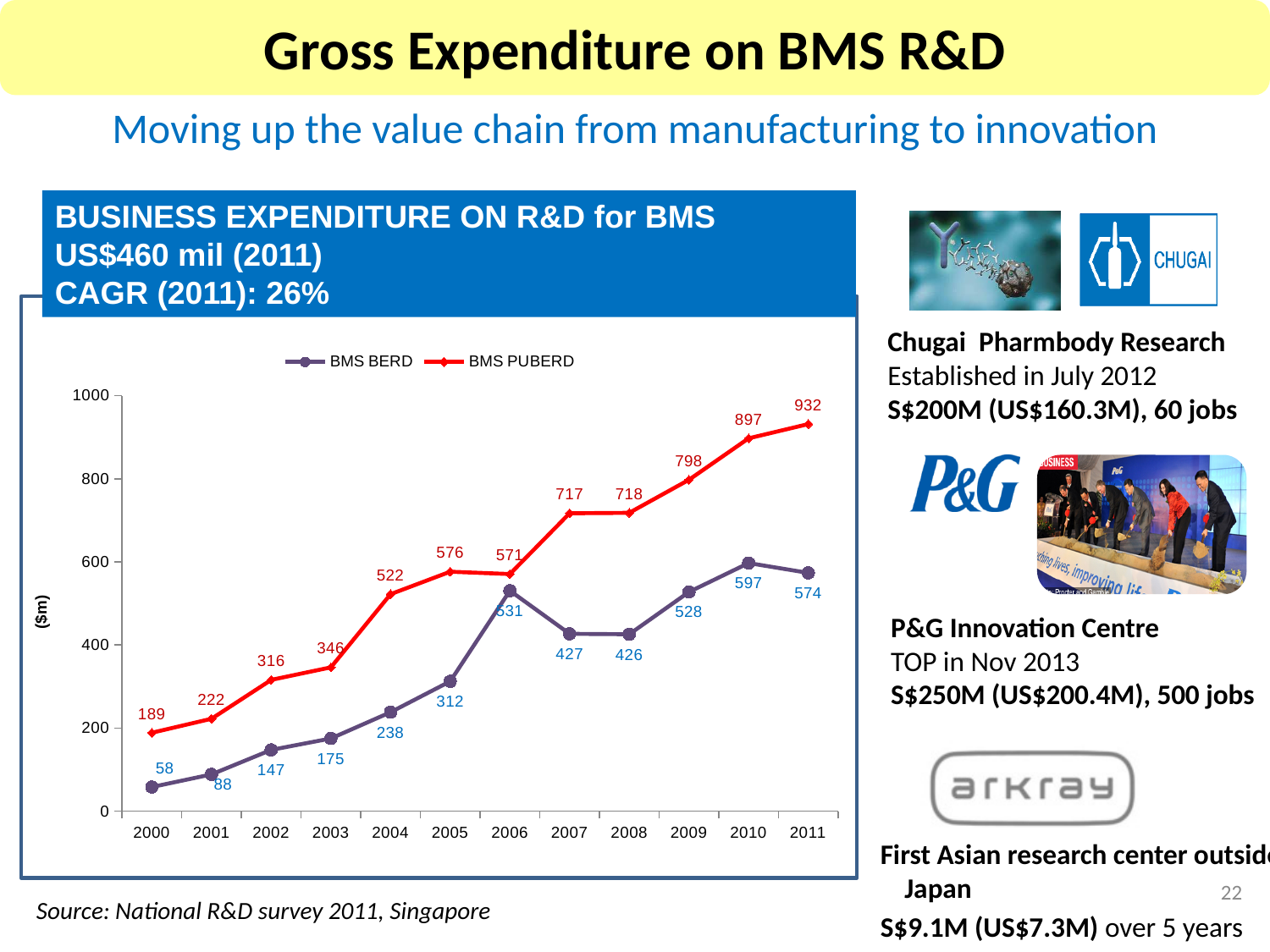
What type of chart is shown on the slide? line chart What is the value of BMS BERD in 2006? 531 Does BMS PUBERD generally rise or fall from 2000 to 2011? rise Which is larger in 2005, BMS BERD or BMS PUBERD? BMS PUBERD In which year is BMS BERD highest? 2010 How many years are shown on the x axis of the chart? 12 What is the value of BMS BERD in 2000? 58 In which year is BMS PUBERD lowest? 2000 What is the difference between BMS PUBERD and BMS BERD in 2011? 358 What is the value of BMS PUBERD in 2011? 932 How many series does the chart legend list? 2 What unit is shown on the y axis of the chart? ($m)